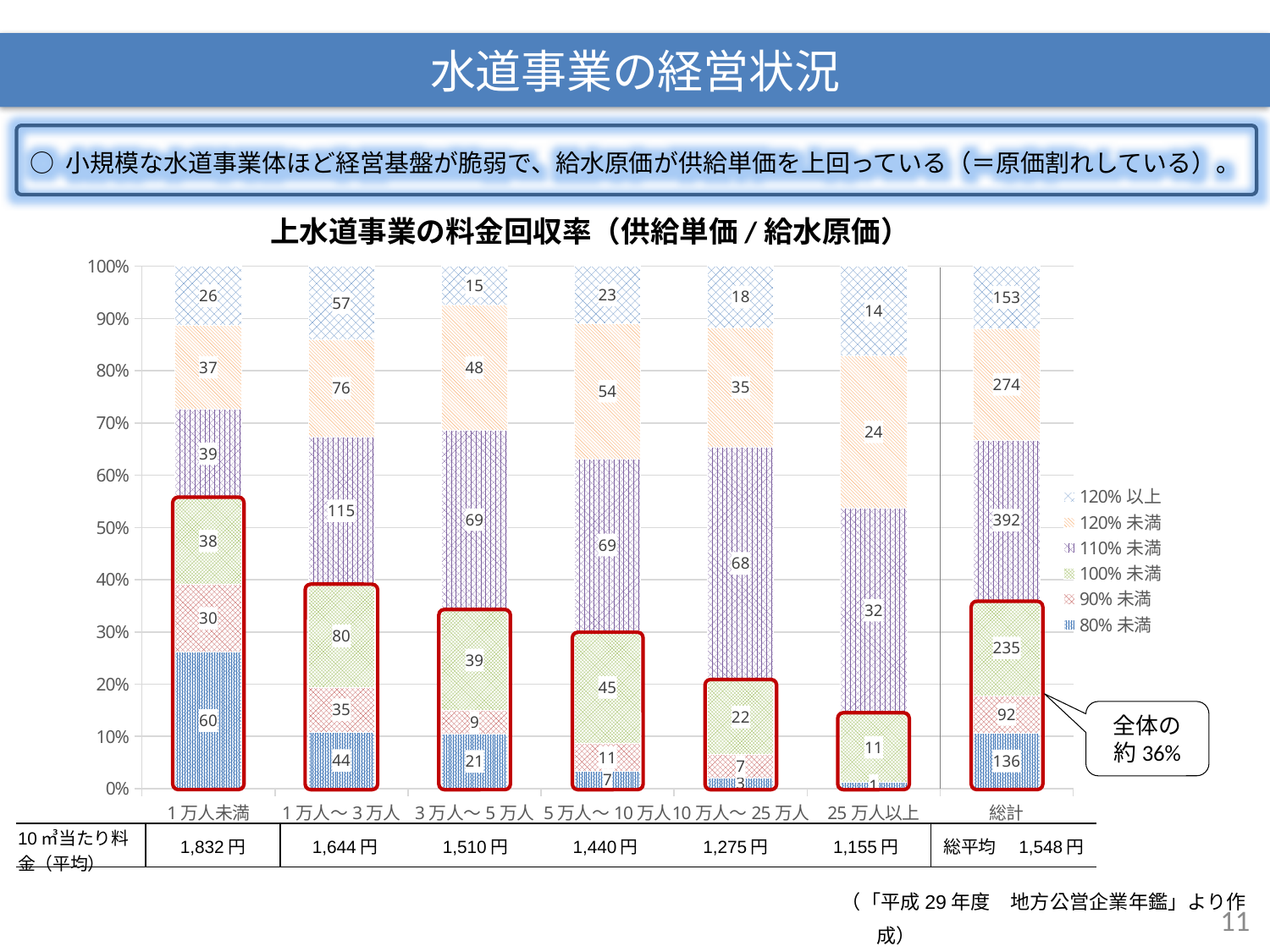
What is the value of the 110%未満 segment for 1万人～3万人? 115 What kind of chart is shown on the slide? Stacked bar chart What is the total of all segments in the 1万人未満 bar? 230 What is the difference between the 100%未満 values for 1万人～3万人 and 3万人～5万人? 41 What is the value of the 120%以上 segment for 総計? 153 Which category has the smallest 120%以上 value? 25万人以上 What is the title of the chart? 上水道事業の料金回収率（供給単価／給水原価） Which is larger, the 120%未満 value for 5万人～10万人 or for 10万人～25万人? 5万人～10万人 How many categories are shown along the x axis? 7 Which category has the largest 80%未満 value? 総計 How many series does the legend list? 6 What is the value of the 80%未満 segment for 1万人未満? 60